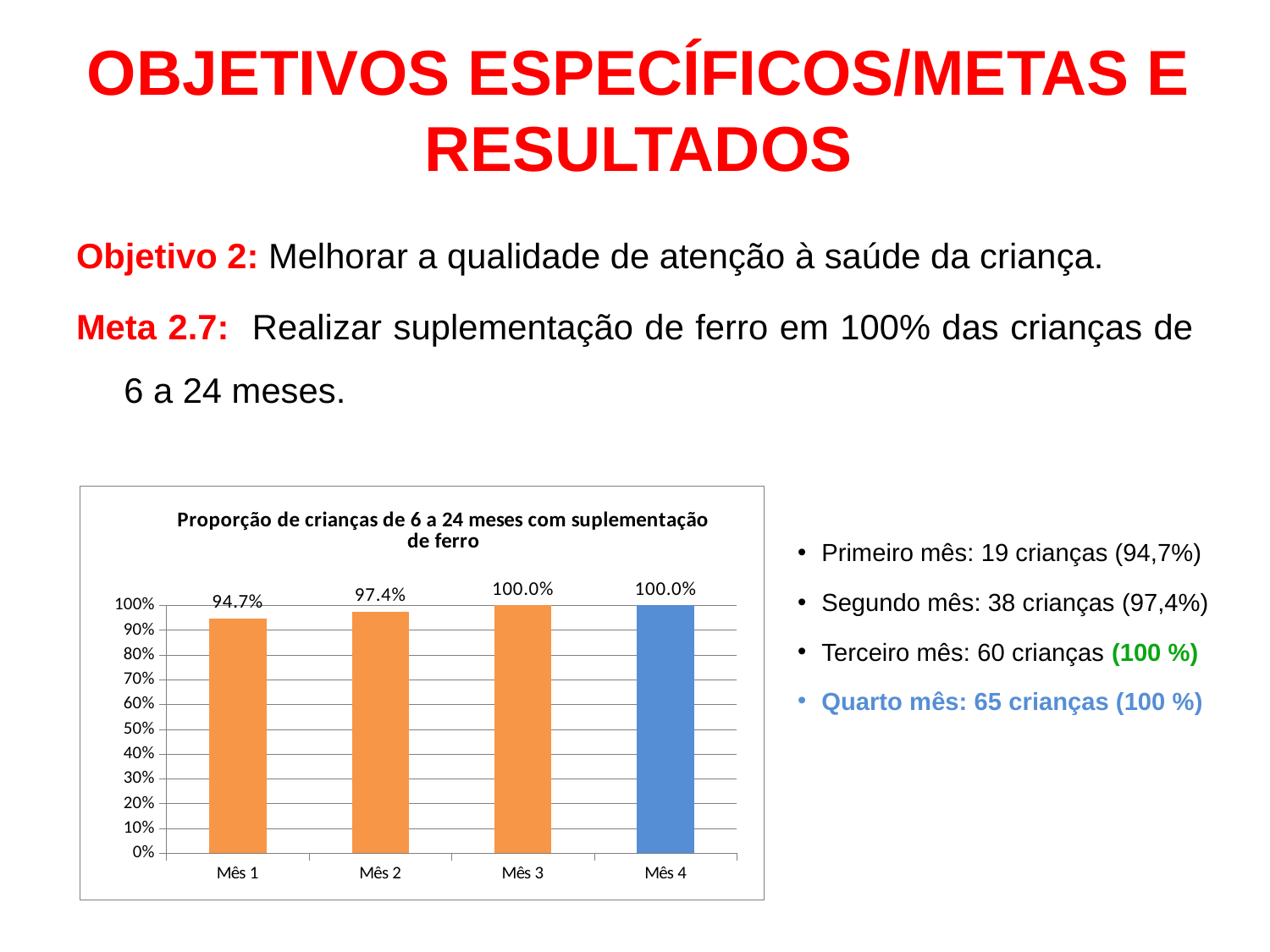
What is the difference between the values for Mês 2 and Mês 1? 2.7% How many months are shown on the x axis? 4 Is the value for Mês 1 greater or less than 90%? greater What is the value for Mês 4? 100.0% What is the difference between the values for Mês 3 and Mês 1? 5.3% What is the value for Mês 3? 100.0% What is the value for Mês 2? 97.4% Which is larger, the value for Mês 1 or the value for Mês 2? Mês 2 Which month has the lowest value? Mês 1 What is the value for Mês 1? 94.7% Do the values rise or fall from Mês 1 to Mês 3? rise What kind of chart is shown? bar chart